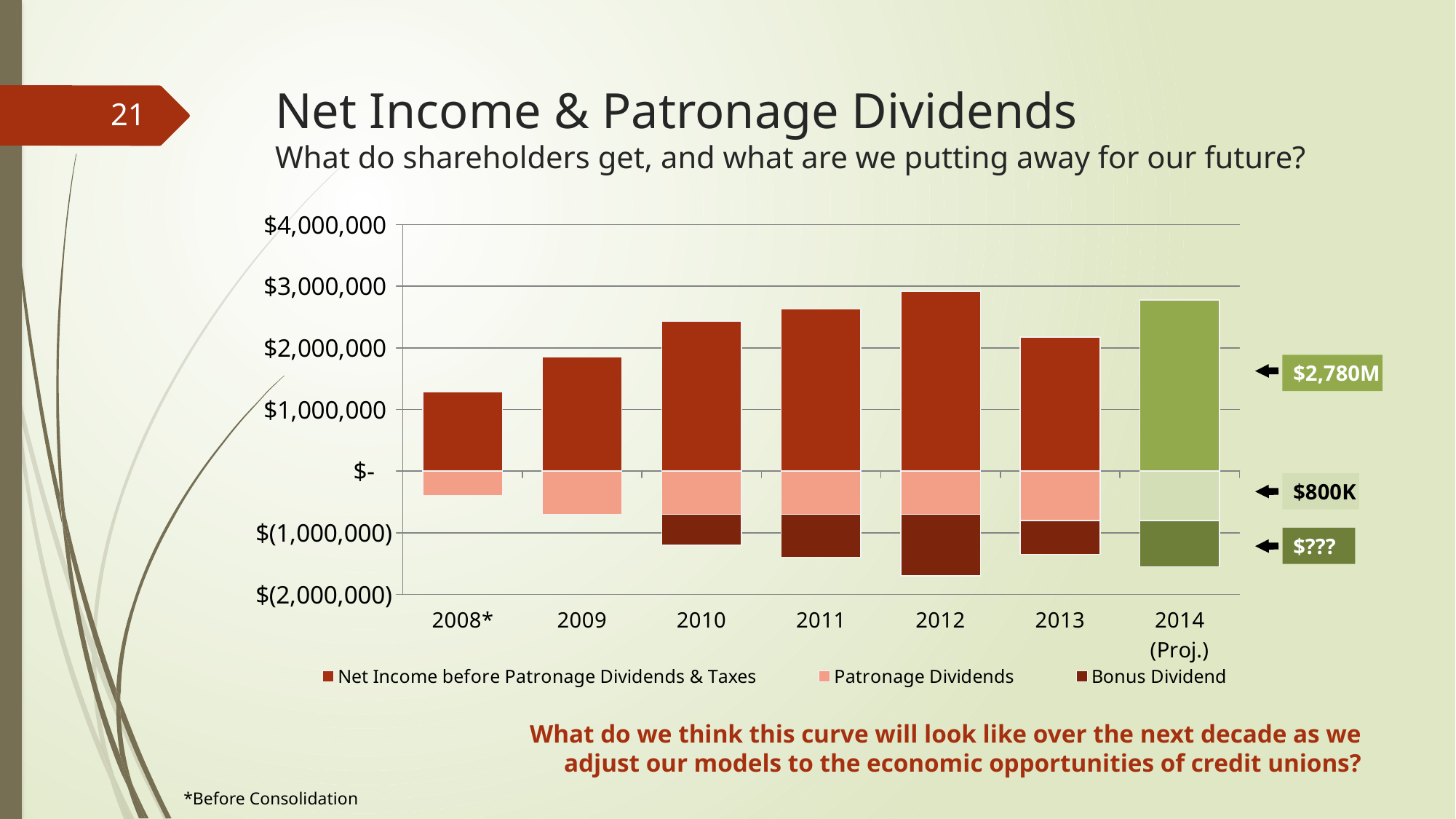
How many series does the legend list? 3 How many years (categories) are shown on the x axis? 7 Does Net Income before Patronage Dividends & Taxes rise or fall from 2008* to 2012? rise What kind of chart is shown on the slide? bar chart Which year has the largest Bonus Dividend? 2012 Is the Net Income before Patronage Dividends & Taxes for 2010 greater or less than $2,000,000? greater Which year has the highest Net Income before Patronage Dividends & Taxes? 2012 What is the labelled projected value for Net Income before Patronage Dividends & Taxes in 2014 (Proj.)? $2,780M What label is shown for the 2014 (Proj.) Bonus Dividend? $??? Is the Net Income before Patronage Dividends & Taxes for 2008* greater or less than $1,000,000? greater Which year has the lowest Net Income before Patronage Dividends & Taxes? 2008* What is the labelled projected value for Patronage Dividends in 2014 (Proj.)? $800K